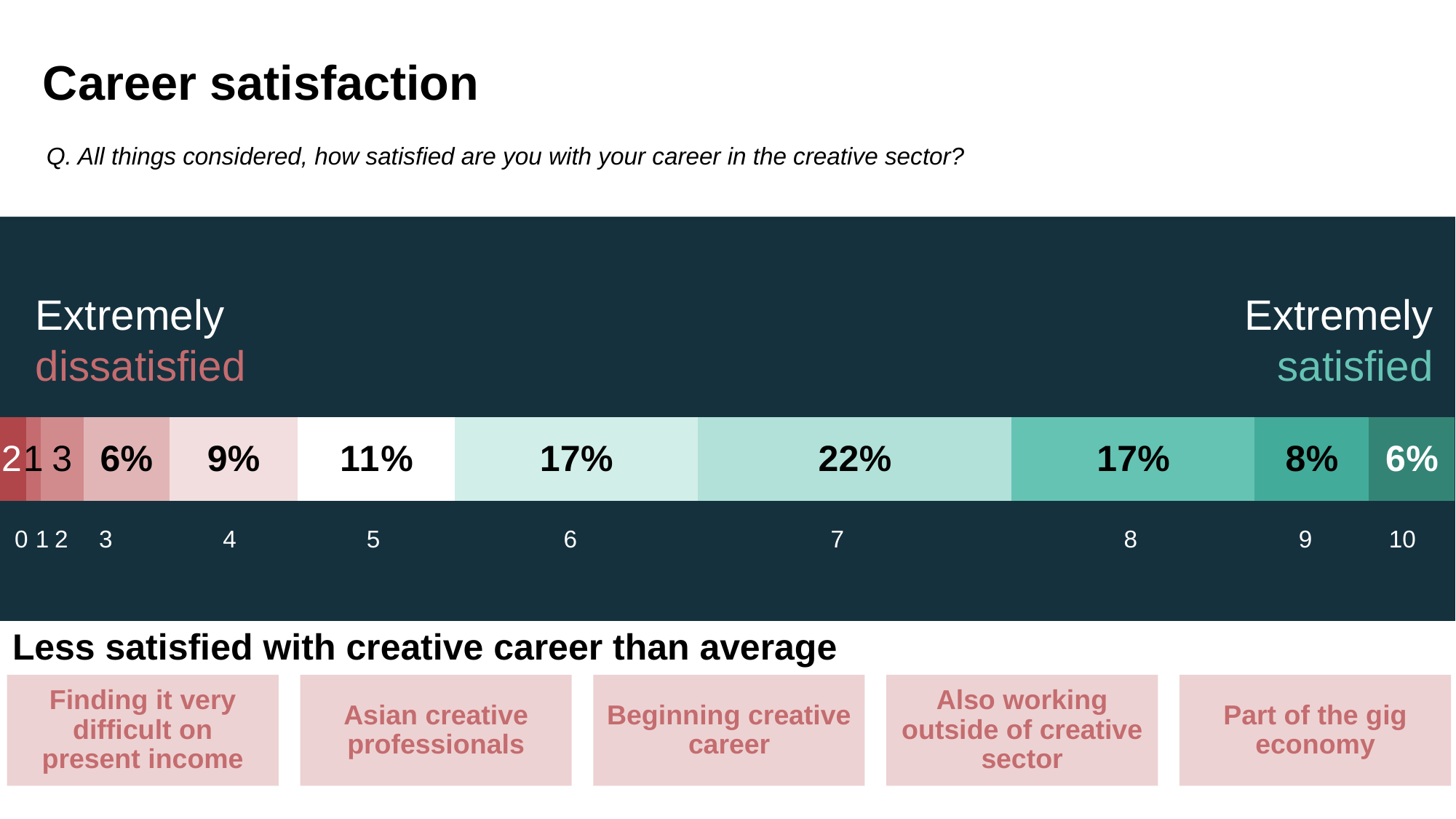
Which has a larger share of respondents, rating 4 or rating 9? Rating 4 What percentage of respondents rated their career satisfaction as 7? 22% What kind of chart is used to show the satisfaction ratings? Bar chart What percentage of respondents gave a rating of 4? 9% Which rating on the 0-10 scale has the highest percentage of respondents? 7 What is the difference in percentage points between the rating 7 segment and the rating 8 segment? 5% What percentage of respondents gave a rating of 5? 11% What percentage of respondents gave a rating of 10 (extremely satisfied)? 6% What is the title of the slide containing the chart? Career satisfaction What is the combined percentage of respondents who gave a rating of 9 or 10? 14% Do the percentages rise or fall as the rating goes from 7 to 10? Fall How many rating categories are shown along the scale? 11